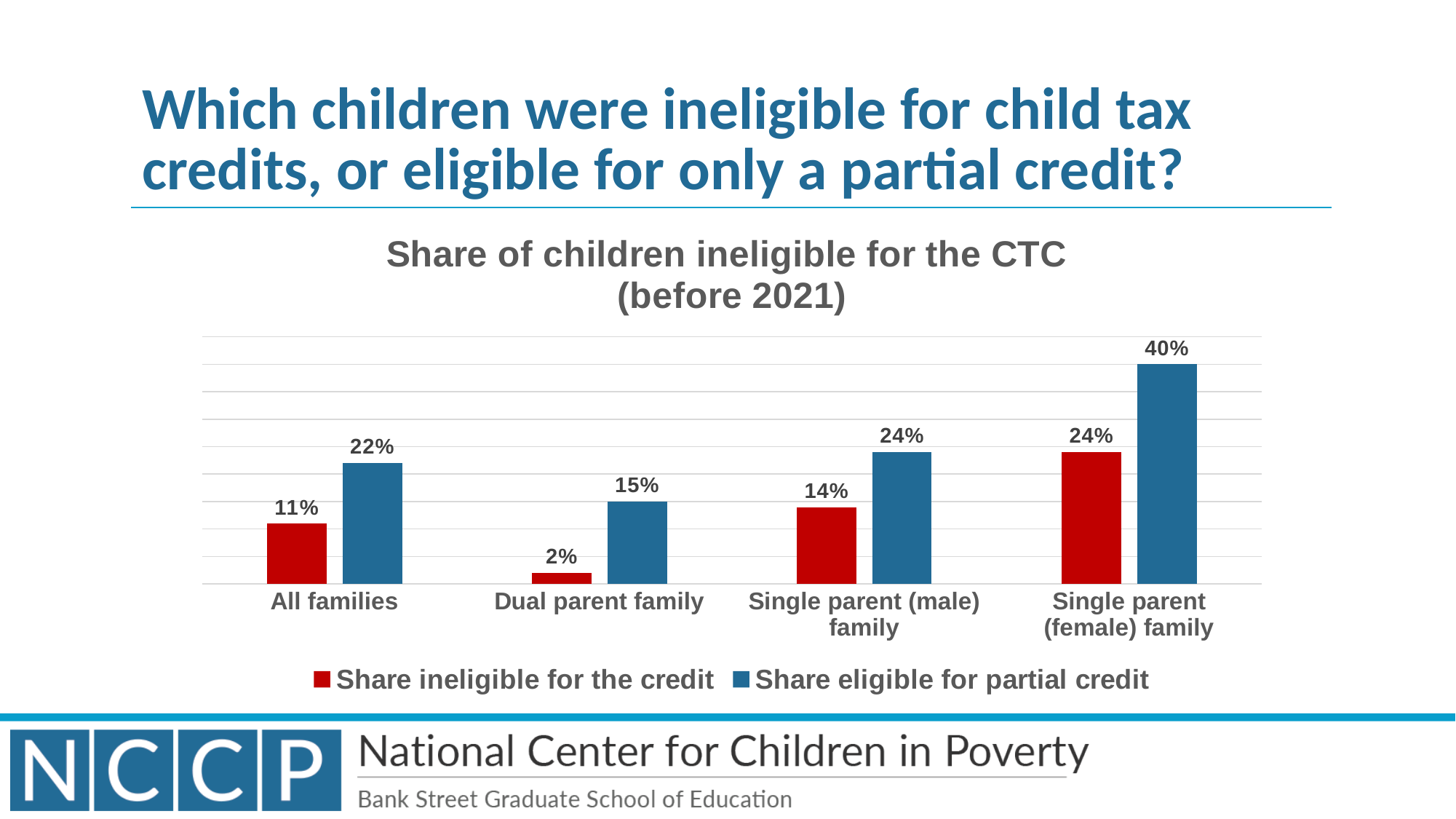
How many family categories are shown on the x axis? 4 What is the difference in the share ineligible for the credit between Single parent (male) family and Dual parent family? 12% What is the share ineligible for the credit for Single parent (female) family? 24% What is the share eligible for partial credit for Dual parent family? 15% Which family type has the highest share eligible for partial credit? Single parent (female) family Which family type has the lowest share ineligible for the credit? Dual parent family What is the share of children ineligible for the credit for All families? 11% What is the difference between the share eligible for partial credit and the share ineligible for the credit for Single parent (female) family? 16% Which is larger: the share eligible for partial credit for All families or for Single parent (male) family? Single parent (male) family What kind of chart is shown on the slide? Bar chart How many series does the legend list? 2 What is the title of the chart? Share of children ineligible for the CTC (before 2021)